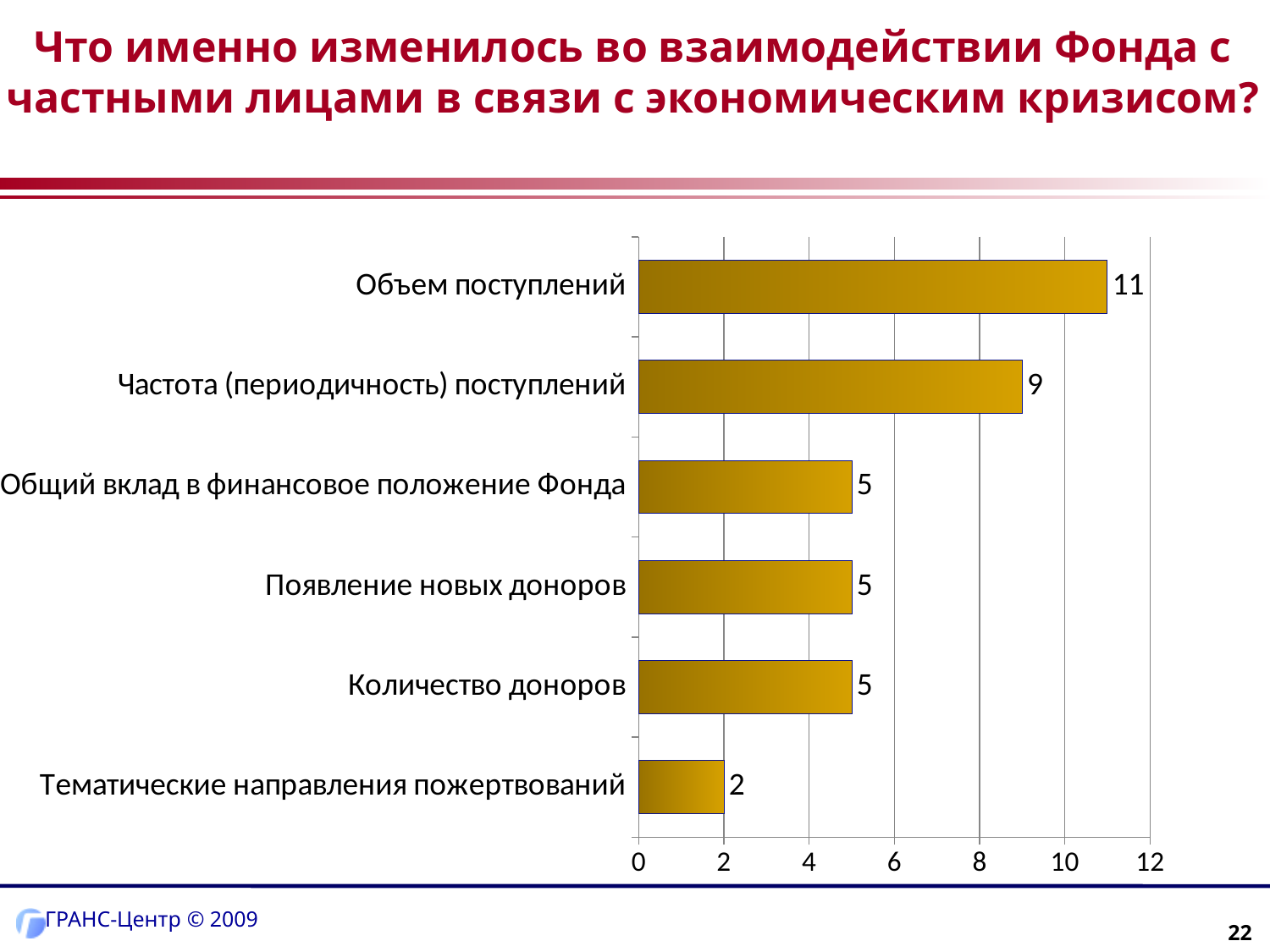
What is the value for Объем поступлений? 11 Which category has the highest value? Объем поступлений Which category has the lowest value? Тематические направления пожертвований What is the value for Количество доноров? 5 What is the difference between the values for Появление новых доноров and Тематические направления пожертвований? 3 What is the value for Частота (периодичность) поступлений? 9 Which is larger, the value for Частота (периодичность) поступлений or the value for Общий вклад в финансовое положение Фонда? Частота (периодичность) поступлений What is the difference between the values for Объем поступлений and Частота (периодичность) поступлений? 2 How many categories are shown in the chart? 6 What kind of chart is shown on the slide? bar chart What is the value for Тематические направления пожертвований? 2 How many categories have a value of 5? 3